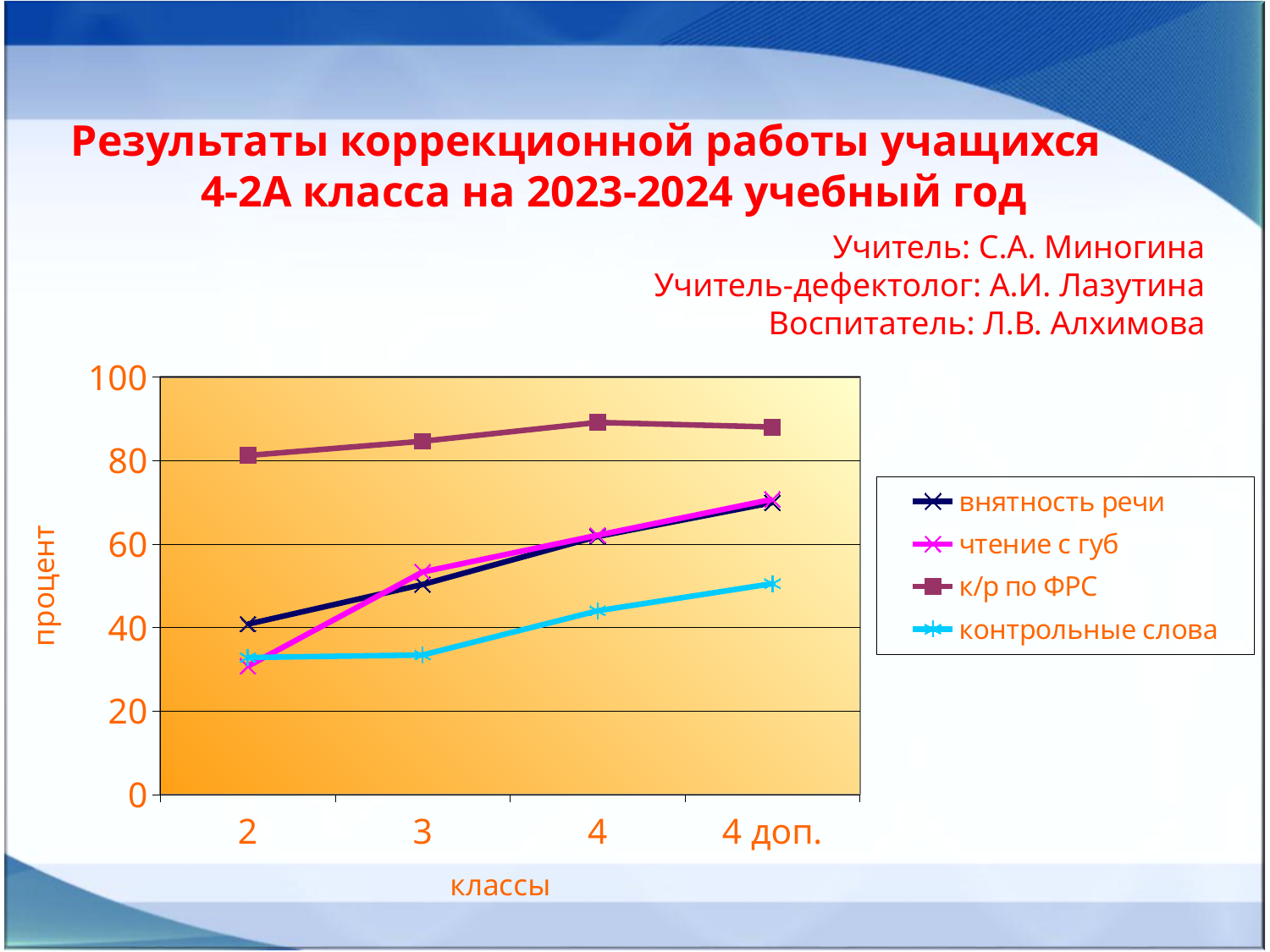
Is the value for к/р по ФРС at class 4 greater or less than 80? greater Is the value for контрольные слова at 4 доп. greater or less than 60? less How many categories are shown on the x axis? 4 How many series does the legend list? 4 At class 3, which is larger: внятность речи or контрольные слова? внятность речи Which series has the lowest value at 4 доп.? контрольные слова What kind of chart is shown on the slide? line chart What is the title of the vertical axis? процент Is the value for внятность речи at class 2 greater or less than 60? less Which series has the highest value at class 2? к/р по ФРС Do the values for контрольные слова rise or fall from class 2 to 4 доп.? rise What is the title of the horizontal axis? классы